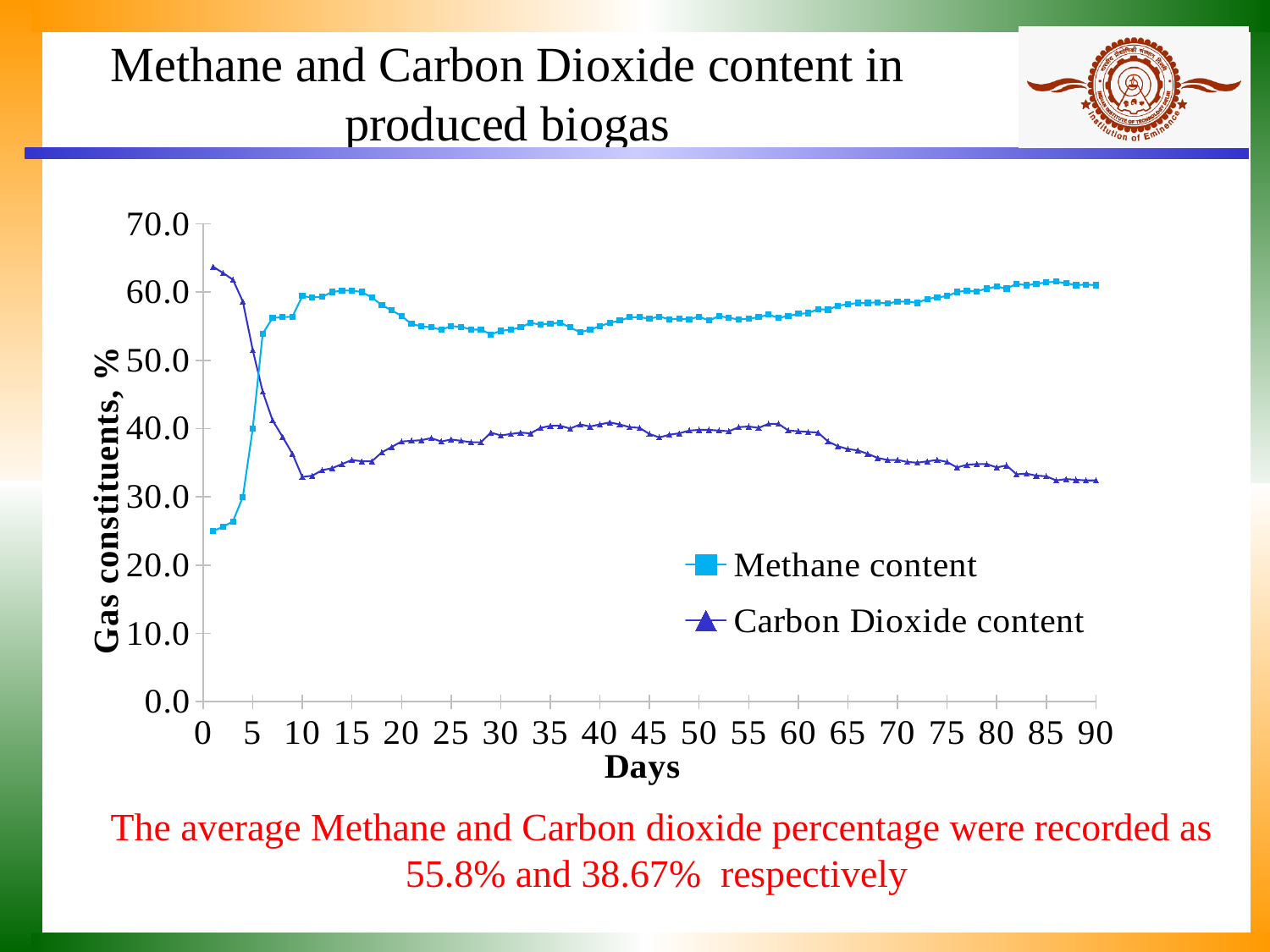
What is the label of the y axis? Gas constituents, % Is the Methane content value at day 90 greater or less than 50.0? greater At day 1, which series has the higher value, Methane content or Carbon Dioxide content? Carbon Dioxide content What are the two series named in the legend? Methane content and Carbon Dioxide content Is the Carbon Dioxide content value at day 90 greater or less than 40.0? less What kind of chart is shown on the slide? Line chart How many series does the legend list? 2 Is the Methane content value at day 1 greater or less than 30.0? less At day 90, which series has the higher value, Methane content or Carbon Dioxide content? Methane content Overall, does the Carbon Dioxide content rise or fall from day 0 to day 90? Fall